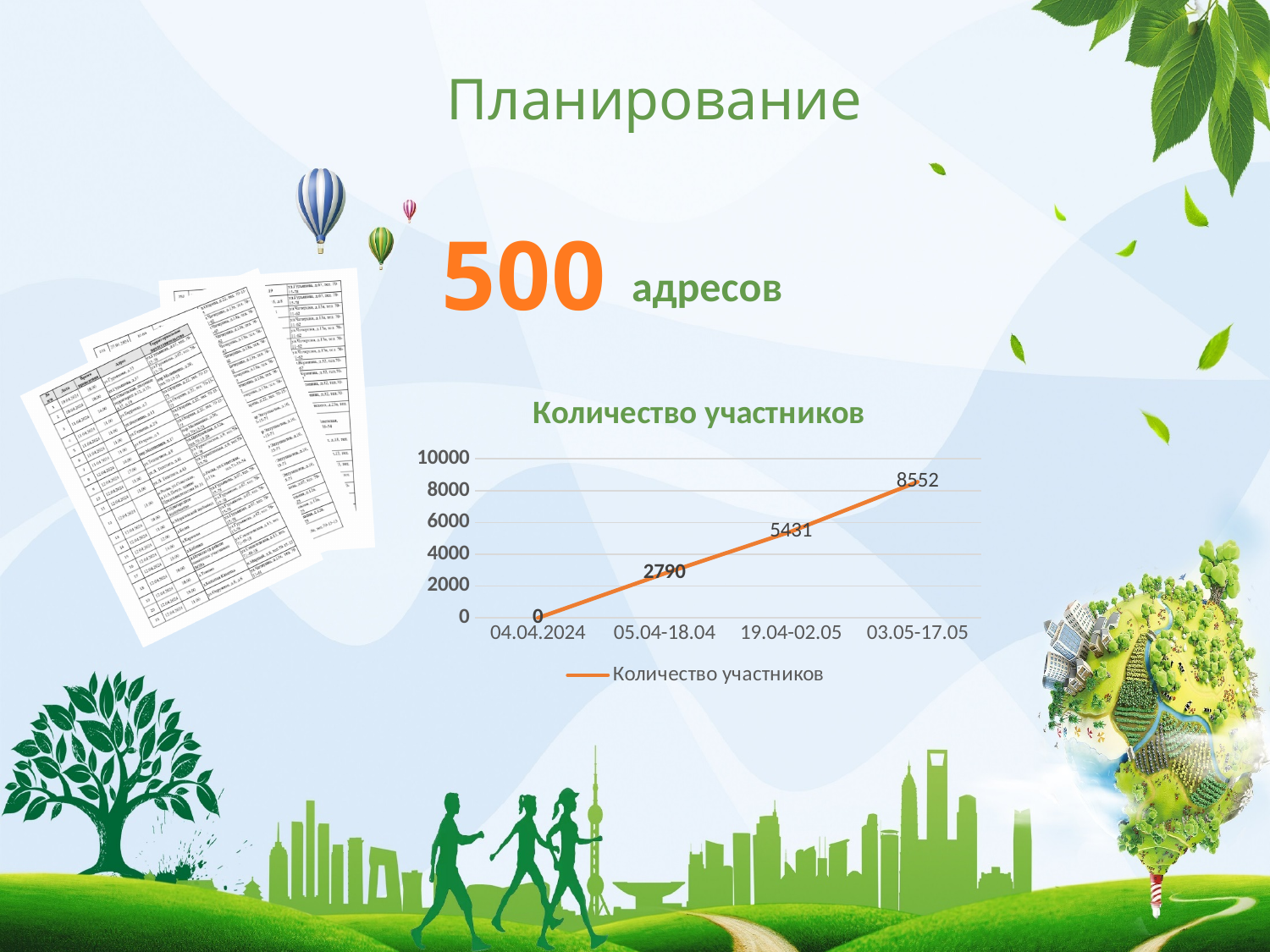
What is the difference between the values for 03.05-17.05 and 19.04-02.05? 3121 What is the value for 03.05-17.05? 8552 What is the title of the chart? Количество участников Do the values rise or fall along the x axis? rise Which category has the highest value? 03.05-17.05 What is the value for 19.04-02.05? 5431 How many data points are plotted on the chart? 4 What type of chart is shown on the slide? line chart What is the value for 05.04-18.04? 2790 Which is larger, the value for 05.04-18.04 or the value for 19.04-02.05? 19.04-02.05 What is the value for 04.04.2024? 0 Which category has the lowest value? 04.04.2024